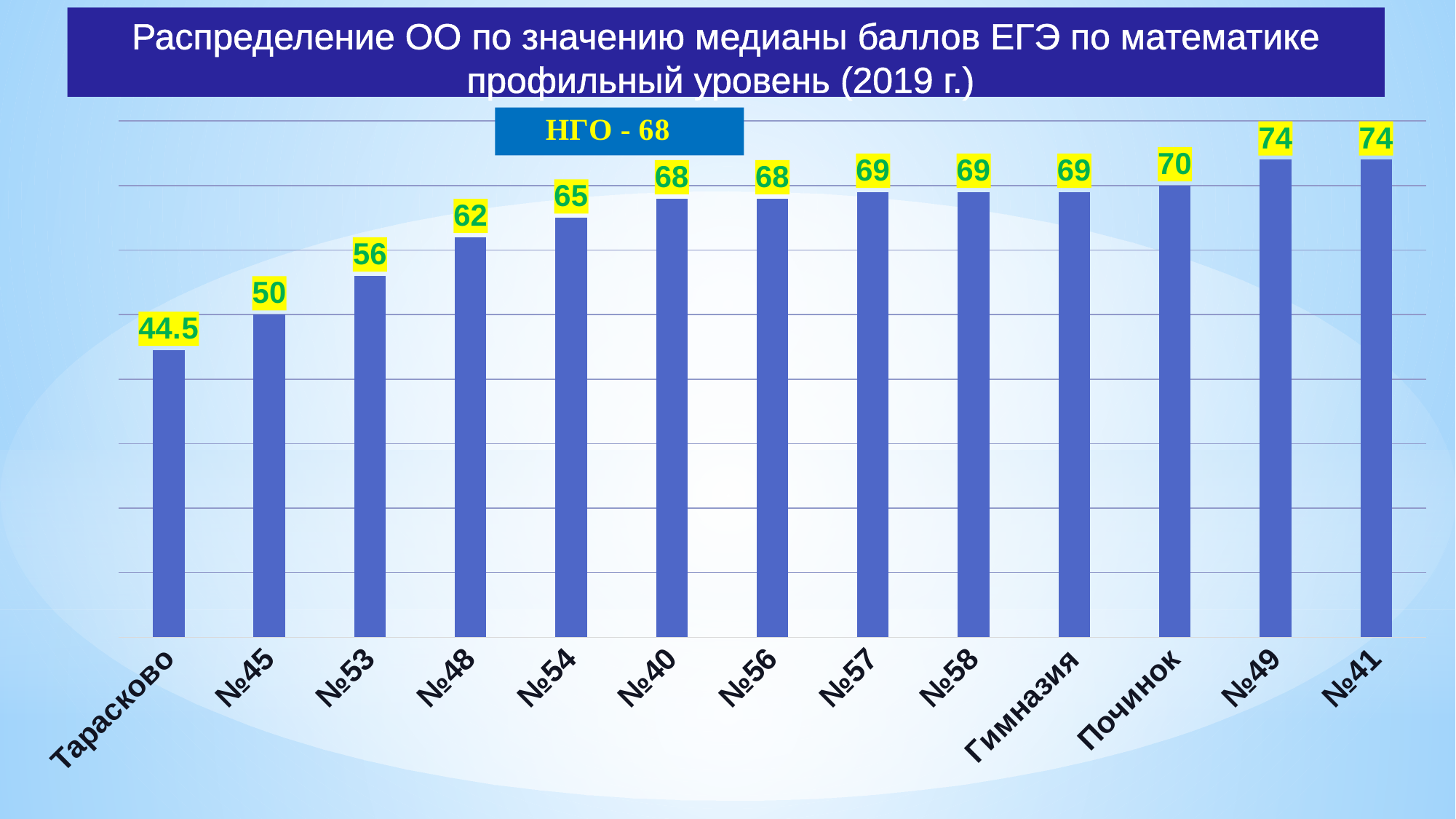
How many schools (bars) are shown on the chart? 13 What type of chart is shown on the slide? Bar chart What value is shown for Починок? 70 What is the difference between the values for №41 and Тарасково? 29.5 What value is shown for №48? 62 What value is shown for Гимназия? 69 What is the difference between the values for №54 and №45? 15 Which school has the lowest median score on the chart? Тарасково What is the median score shown for Тарасково? 44.5 Which has a higher value, №53 or №40? №40 What is the highest value shown on the chart? 74 What value is given for НГО in the label above the chart? 68